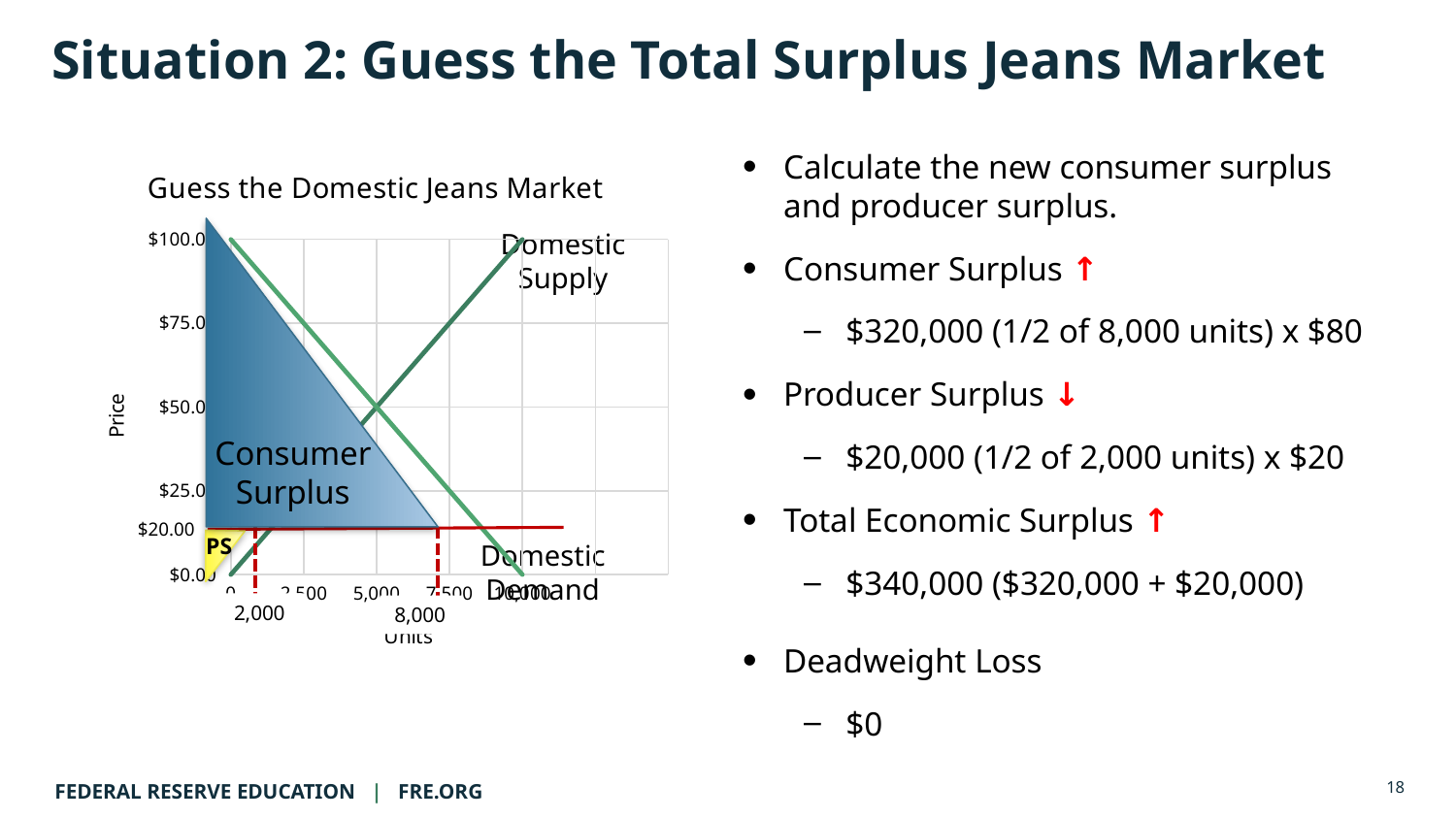
Does the Domestic Supply line rise or fall as units increase along the x axis? rise At what quantity of units does the Domestic Demand line reach the $20.00 price line? 8,000 What is the title of the chart on the slide? Guess the Domestic Jeans Market Is the price on the Domestic Supply line at 7,500 units greater or less than $50.0? greater What kind of chart is shown on the slide? line chart What is the price on the Domestic Demand line at 0 units? $100.0 What is the label of the vertical axis of the chart? Price At what quantity of units does the Domestic Supply line reach the $20.00 price line? 2,000 At what price is the horizontal red line drawn on the chart? $20.00 Is the price on the Domestic Demand line at 2,500 units greater or less than $50.0? greater How many lines (series) are labeled on the chart? 2 Does the Domestic Demand line rise or fall as units increase along the x axis? fall